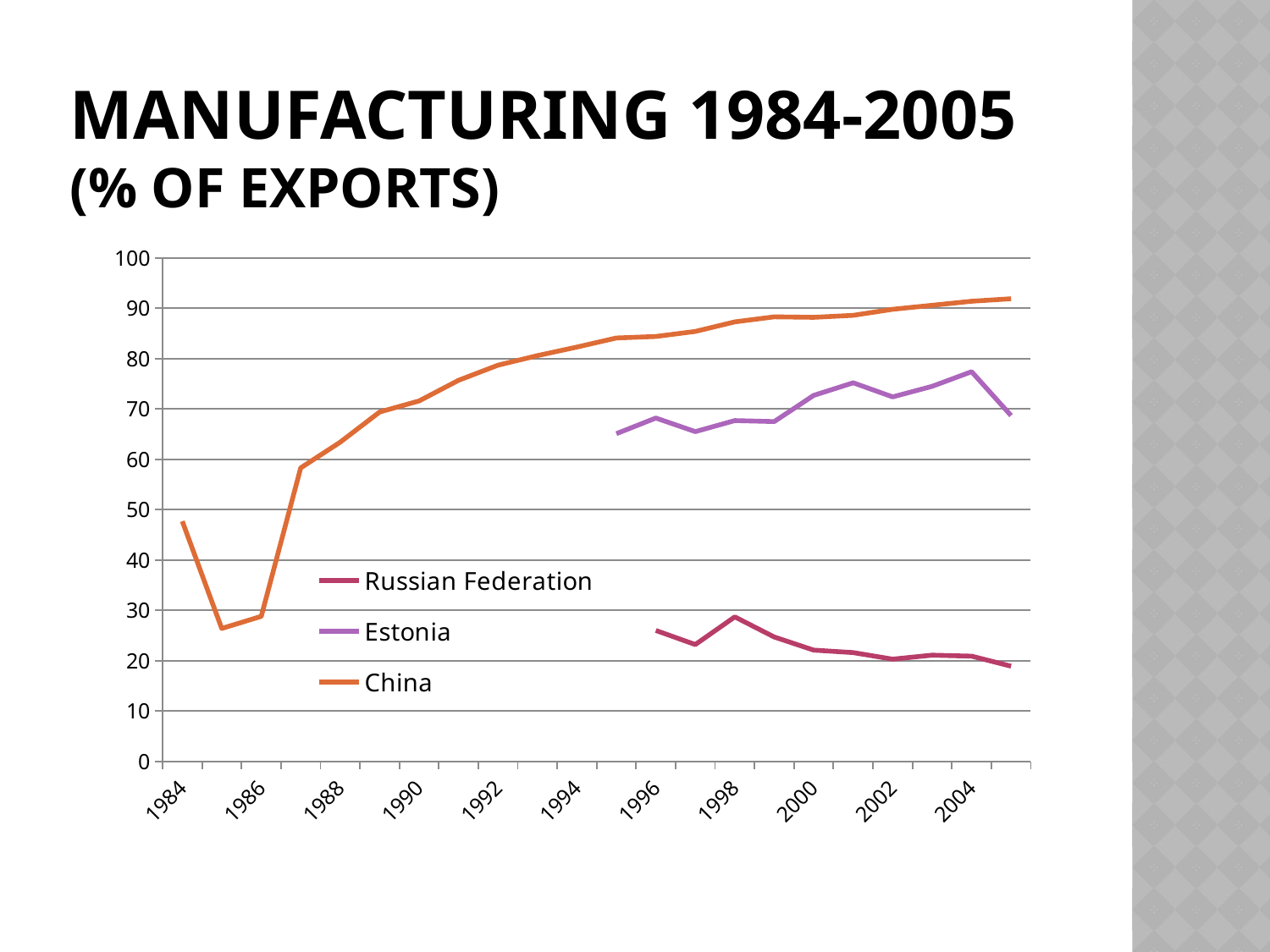
How many series does the legend list? 3 In 2000, which is larger, the value for China or the value for Estonia? China Which series are listed in the legend? Russian Federation, Estonia, China What kind of chart is shown on the slide? line chart Is the value for Estonia in 2004 greater or less than 70? greater Is the value for the Russian Federation in 2000 greater or less than 30? less Is the value for China in 2000 greater or less than 80? greater Which series has the lowest value in 2004? Russian Federation Does the value for China generally rise or fall from 1988 to 2004? rise What is the title of the chart? Manufacturing 1984-2005 (% of exports) Which series has the highest value in 2004? China